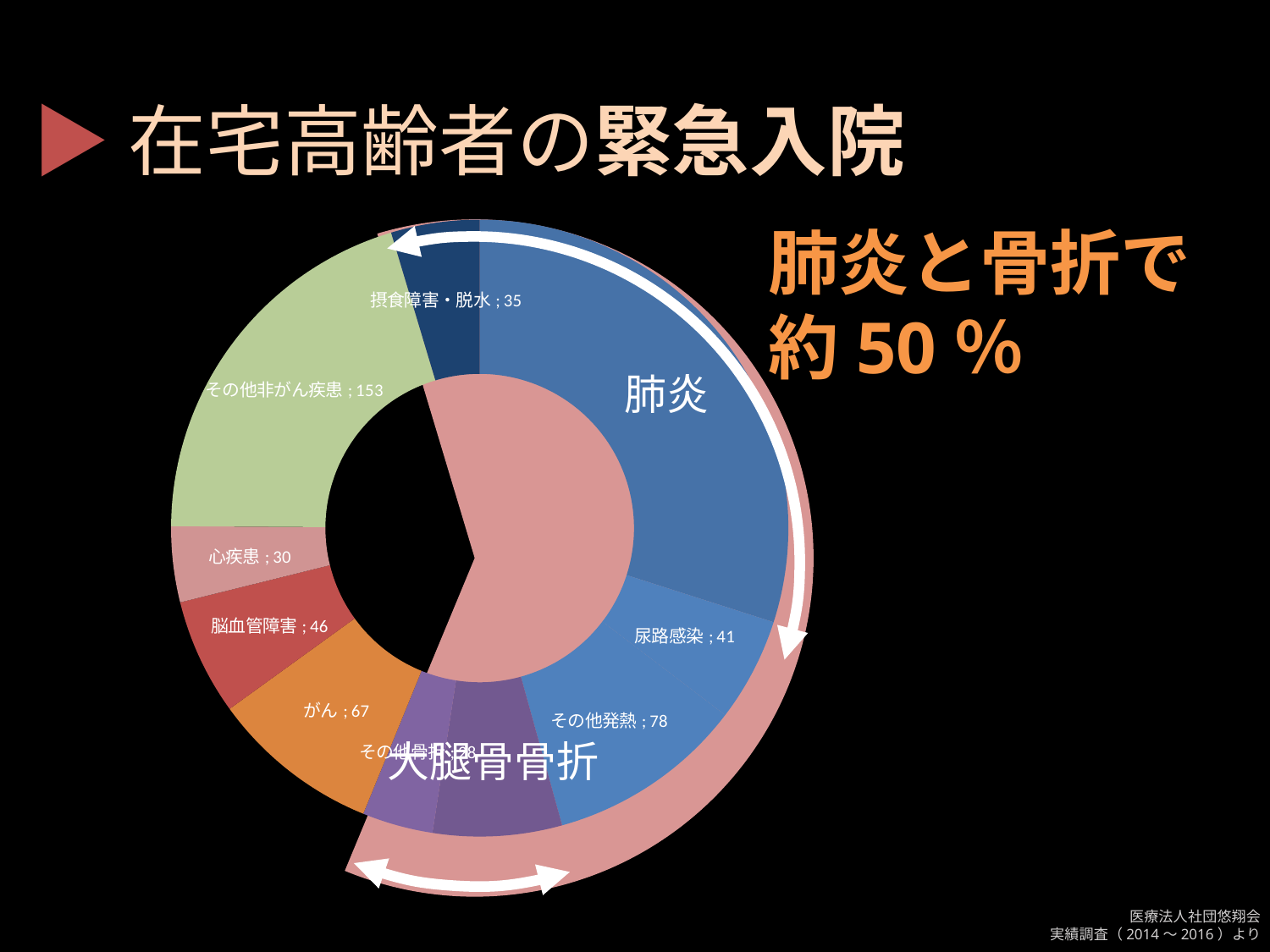
What is the value for 心疾患? 30 What kind of chart is shown on the slide? Doughnut (pie) chart Which category has the largest slice in the chart? 肺炎 What is the value for その他非がん疾患? 153 What is the value for 摂食障害・脱水? 35 What is the value for 尿路感染? 41 What is the value for がん? 67 What is the value for 脳血管障害? 46 What is the difference between その他非がん疾患 and 摂食障害・脱水? 118 What is the difference between その他発熱 and 尿路感染? 37 What is the value for その他発熱? 78 Which is larger, がん or 脳血管障害? がん